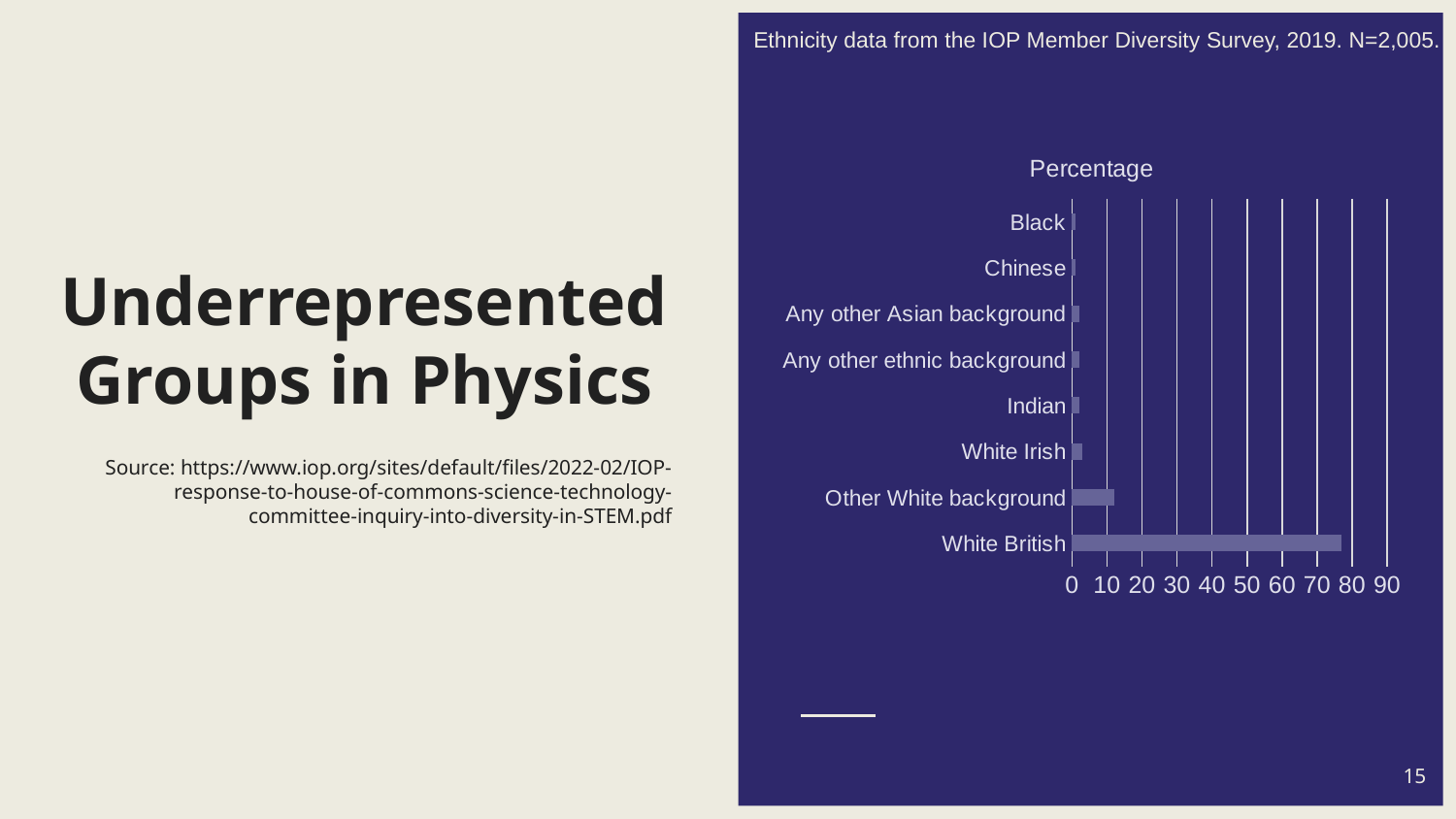
What is the highest tick value shown on the chart's horizontal axis? 90 Which is larger, the value for White British or the value for Other White background? White British Is the value for White British greater or less than 70? greater Is the value for White Irish greater or less than 10? less What is the title of the chart? Percentage What kind of chart is shown on the slide? bar chart Is the value for Other White background greater or less than 10? greater Which is larger, the value for Other White background or the value for Indian? Other White background How many ethnic groups are plotted in the chart? 8 Which ethnic group has the highest percentage in the chart? White British